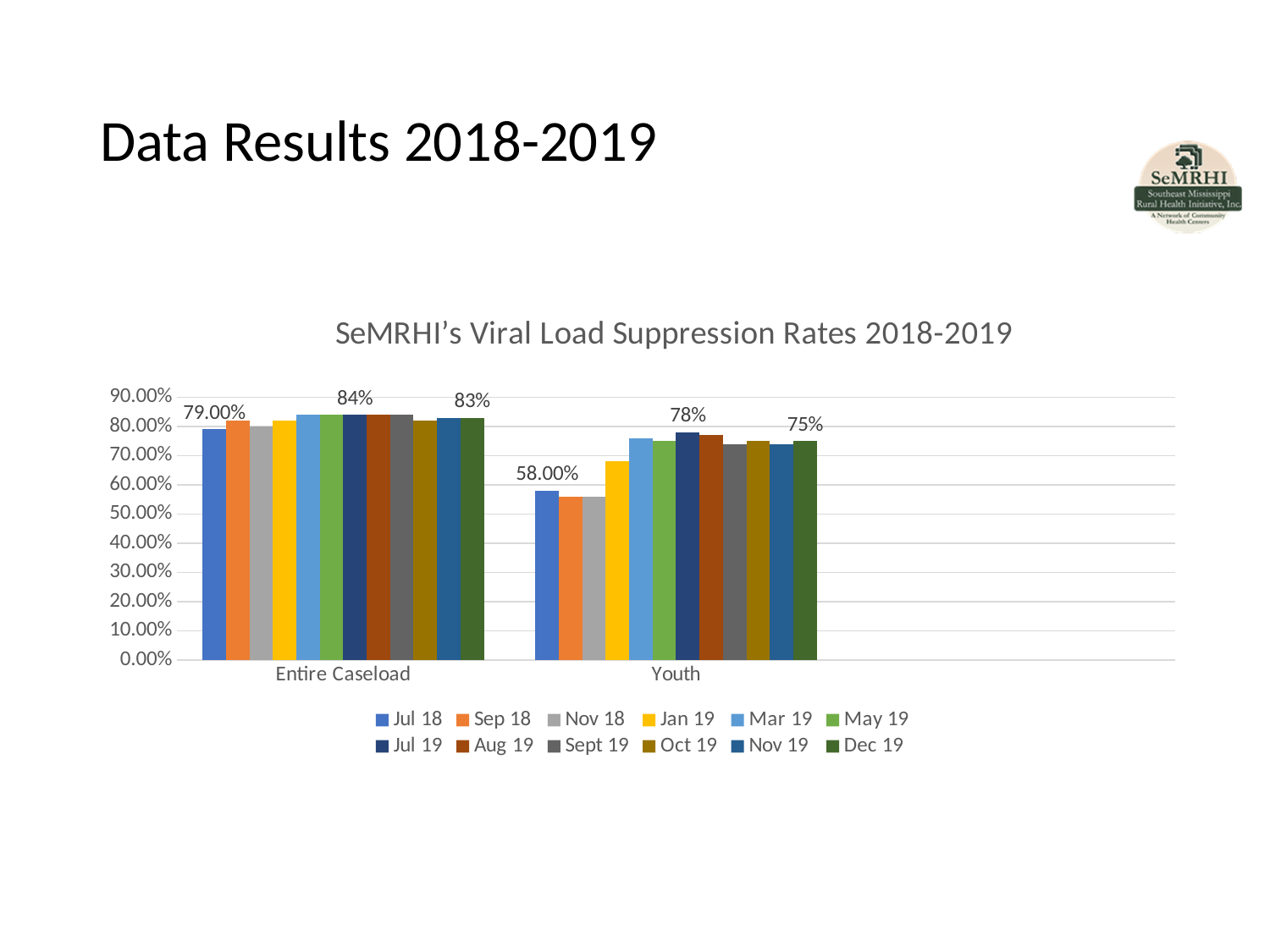
How many categories are shown on the x axis? 2 What is the viral load suppression rate for the Entire Caseload in Jul 18? 79.00% What is the viral load suppression rate for Youth in Jul 18? 58.00% What type of chart is shown on the slide? Bar chart By how many percentage points did the Youth rate increase from Jul 18 to Jul 19? 20 percentage points Which category had the higher rate in Jul 18, Entire Caseload or Youth? Entire Caseload What is the Entire Caseload value for Jul 19? 84% What is the Youth value for Dec 19? 75% Is the Youth value for Jan 19 greater or less than 60.00%? greater What is the Entire Caseload value for Dec 19? 83% What is the Youth value for Jul 19? 78% How many series does the legend list? 12